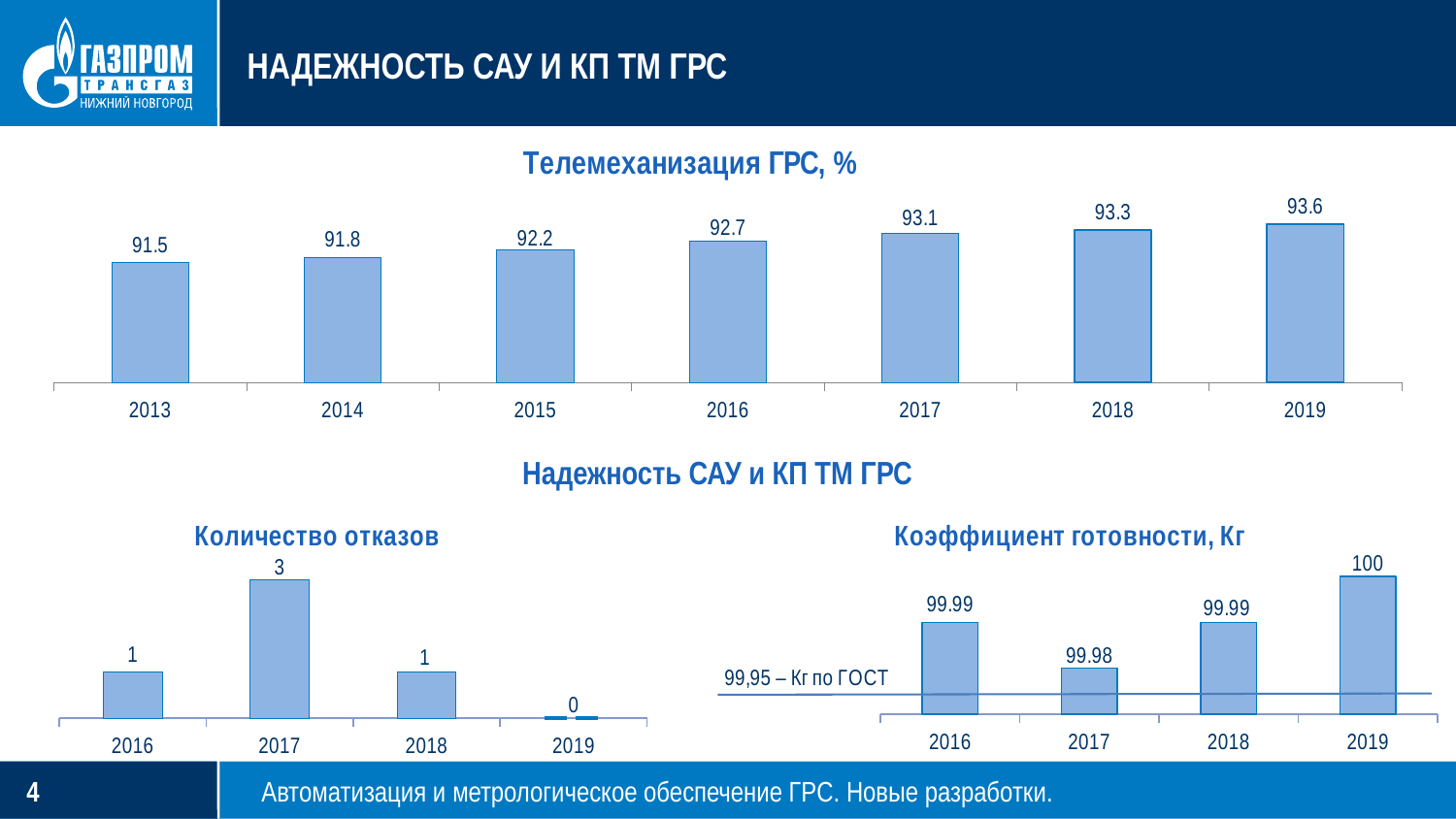
How many years are shown in the chart 'Телемеханизация ГРС, %'? 7 In the chart 'Количество отказов', is the value for 2016 larger or smaller than the value for 2017? smaller In the chart 'Телемеханизация ГРС, %', what is the difference between the values for 2019 and 2013? 2.1 In the chart 'Коэффициент готовности, Кг', which year has the highest value? 2019 In the chart 'Телемеханизация ГРС, %', what is the value for 2013? 91.5 In the chart 'Количество отказов', which year has the lowest value? 2019 What type of chart is 'Коэффициент готовности, Кг'? bar chart In the chart 'Телемеханизация ГРС, %', which year has the highest value? 2019 In the chart 'Количество отказов', what is the value for 2017? 3 In the chart 'Телемеханизация ГРС, %', do the values rise or fall from 2013 to 2019? rise In the chart 'Коэффициент готовности, Кг', what is the value for 2017? 99.98 In the chart 'Коэффициент готовности, Кг', what reference value is labelled on the horizontal line? 99,95 – Кг по ГОСТ